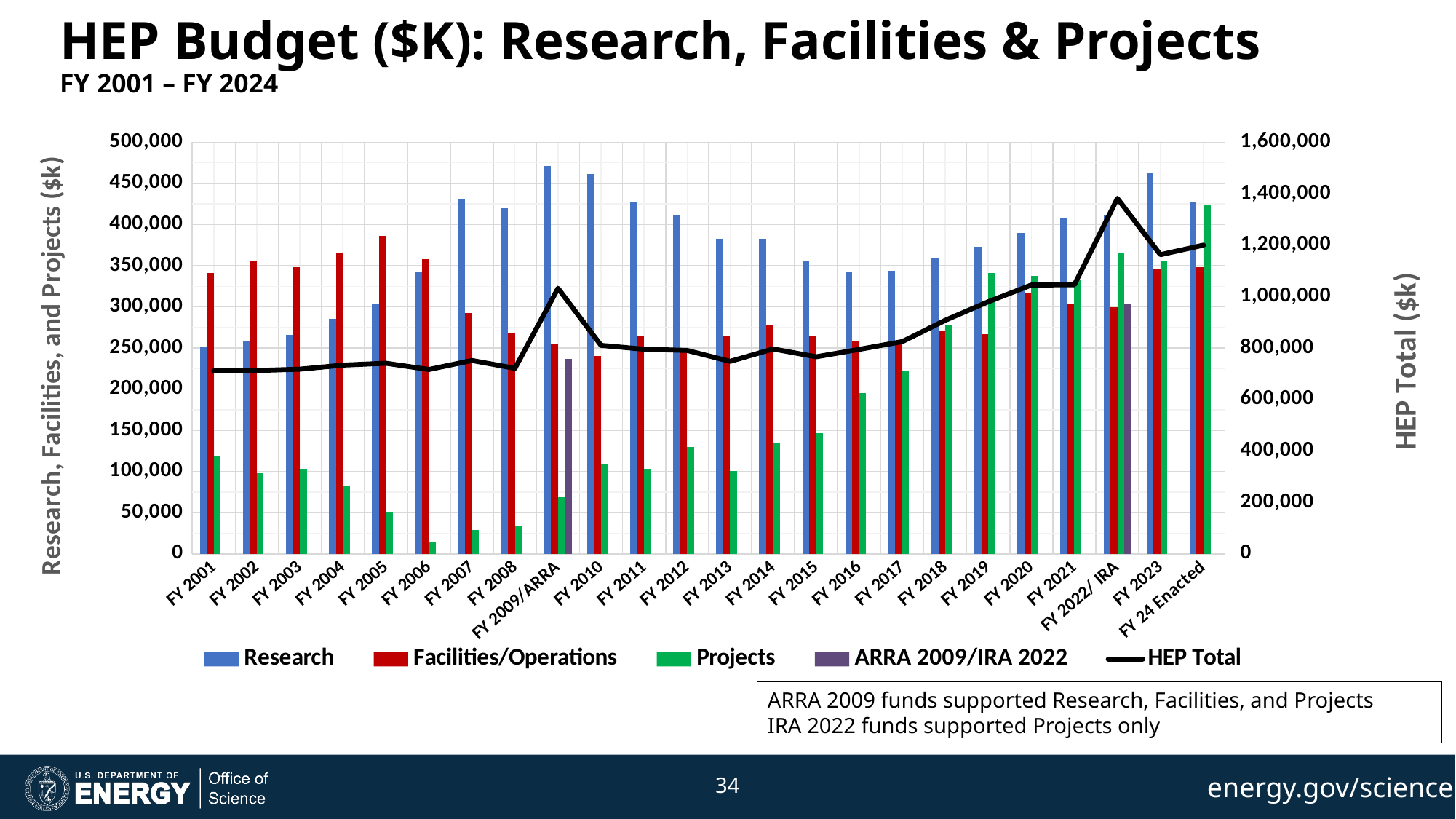
Is the Projects value for FY 2019 greater or less than 300,000? greater Is the Research value for FY 2001 greater or less than 300,000? less How many series does the legend list? 5 Which series is plotted as a line rather than bars? HEP Total How many fiscal years are shown along the x axis? 24 In FY 2001, which is larger: Research or Facilities/Operations? Facilities/Operations What kind of chart is shown on the slide? Bar chart with a line In which fiscal year is the Facilities/Operations value highest? FY 2005 In which fiscal year is the Projects value lowest? FY 2006 Is the HEP Total for FY 2022/ IRA greater or less than 1,200,000? greater In which fiscal year is the Projects value highest? FY 24 Enacted In which fiscal year does the HEP Total line reach its peak? FY 2022/ IRA